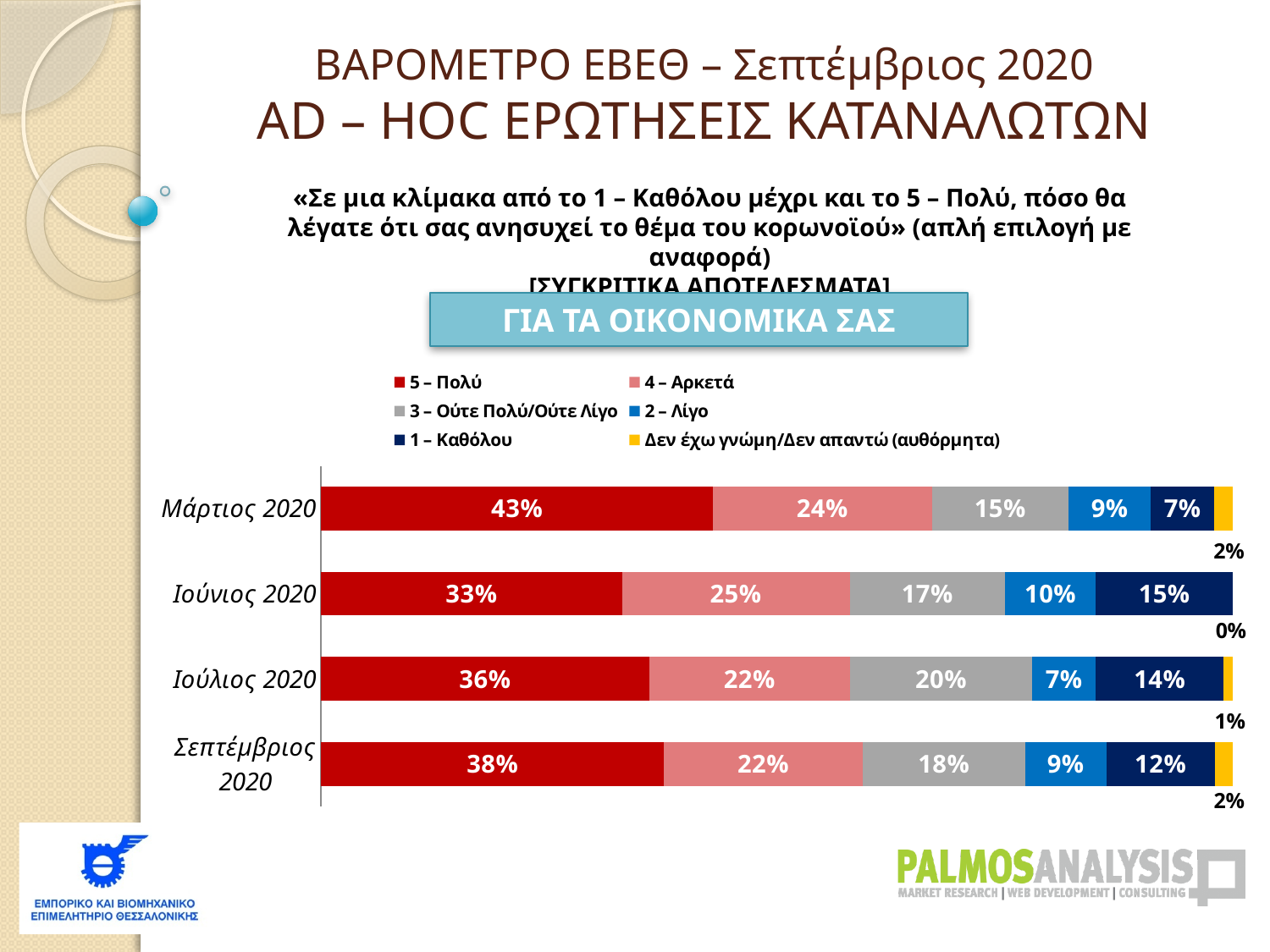
What kind of chart is shown on the slide? Stacked bar chart What is the difference between the "5 – Πολύ" values for Μάρτιος 2020 and Σεπτέμβριος 2020? 5 percentage points What is the value for "5 – Πολύ" in Σεπτέμβριος 2020? 38% How many periods (bars) are shown in the chart? 4 How many series does the legend list? 6 What is the value for "1 – Καθόλου" in Ιούνιος 2020? 15% Which period has the larger value for "3 – Ούτε Πολύ/Ούτε Λίγο": Ιούλιος 2020 or Σεπτέμβριος 2020? Ιούλιος 2020 Which period has the highest value for "5 – Πολύ"? Μάρτιος 2020 What is the value for "Δεν έχω γνώμη/Δεν απαντώ (αυθόρμητα)" in Ιούνιος 2020? 0% Which period has the lowest value for "5 – Πολύ"? Ιούνιος 2020 What is the heading shown in the box above the chart? ΓΙΑ ΤΑ ΟΙΚΟΝΟΜΙΚΑ ΣΑΣ Does the value for "1 – Καθόλου" rise or fall from Ιούνιος 2020 to Σεπτέμβριος 2020? Fall